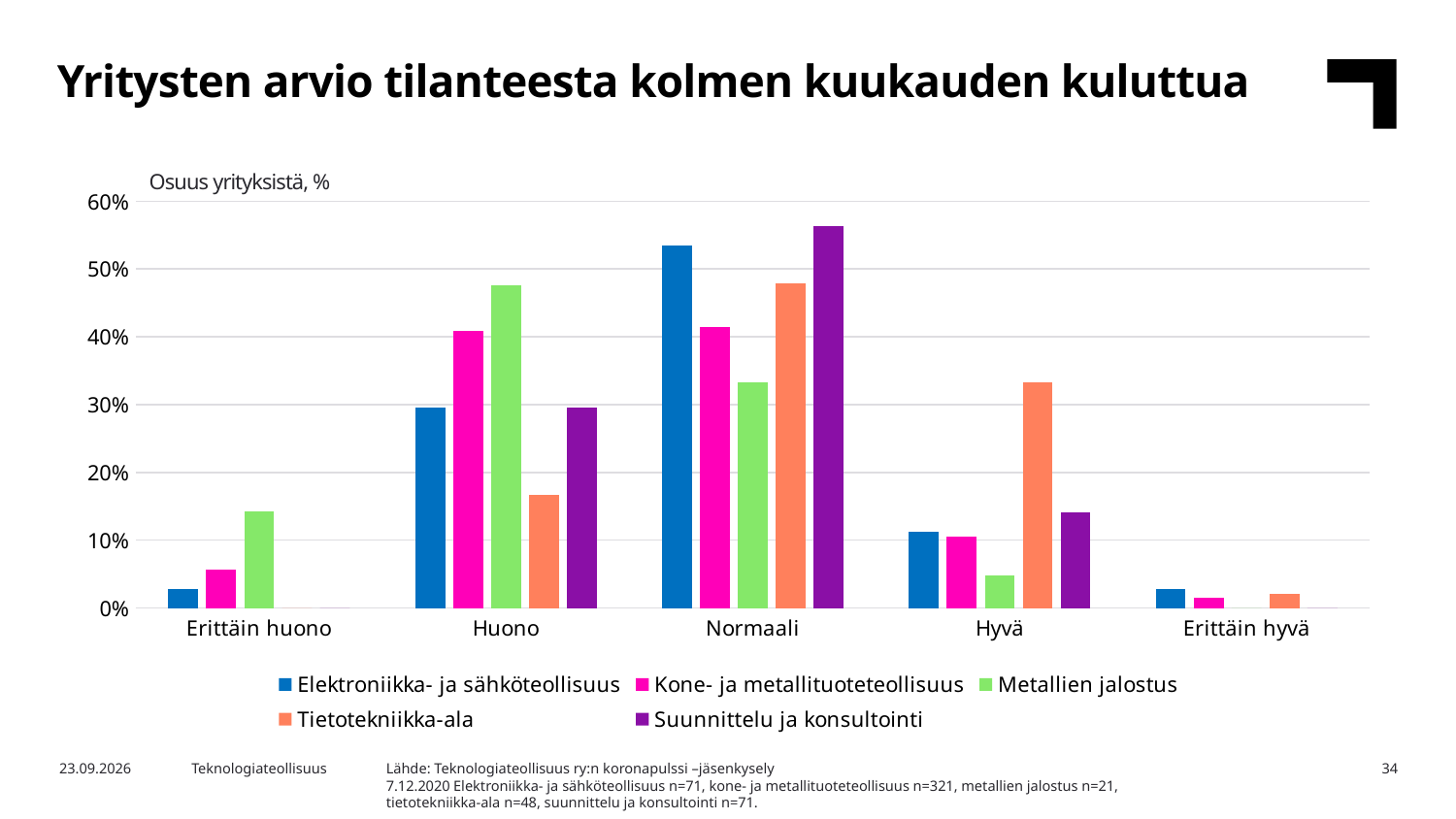
In the Hyvä category, which series has the lowest value? Metallien jalostus How many series does the legend list? 5 What is the title of the slide? Yritysten arvio tilanteesta kolmen kuukauden kuluttua Is the value for Metallien jalostus in the Erittäin huono category greater or less than 10%? greater Is the value for Tietotekniikka-ala in the Hyvä category greater or less than 30%? greater In the Huono category, which series has the highest value? Metallien jalostus In the Huono category, which is larger: Kone- ja metallituoteteollisuus or Tietotekniikka-ala? Kone- ja metallituoteteollisuus In the Hyvä category, which series has the highest value? Tietotekniikka-ala What is the label shown above the y axis of the chart? Osuus yrityksistä, % Is the value for Elektroniikka- ja sähköteollisuus in the Normaali category greater or less than 50%? greater What kind of chart is shown on the slide? Bar chart How many categories are shown on the x axis? 5